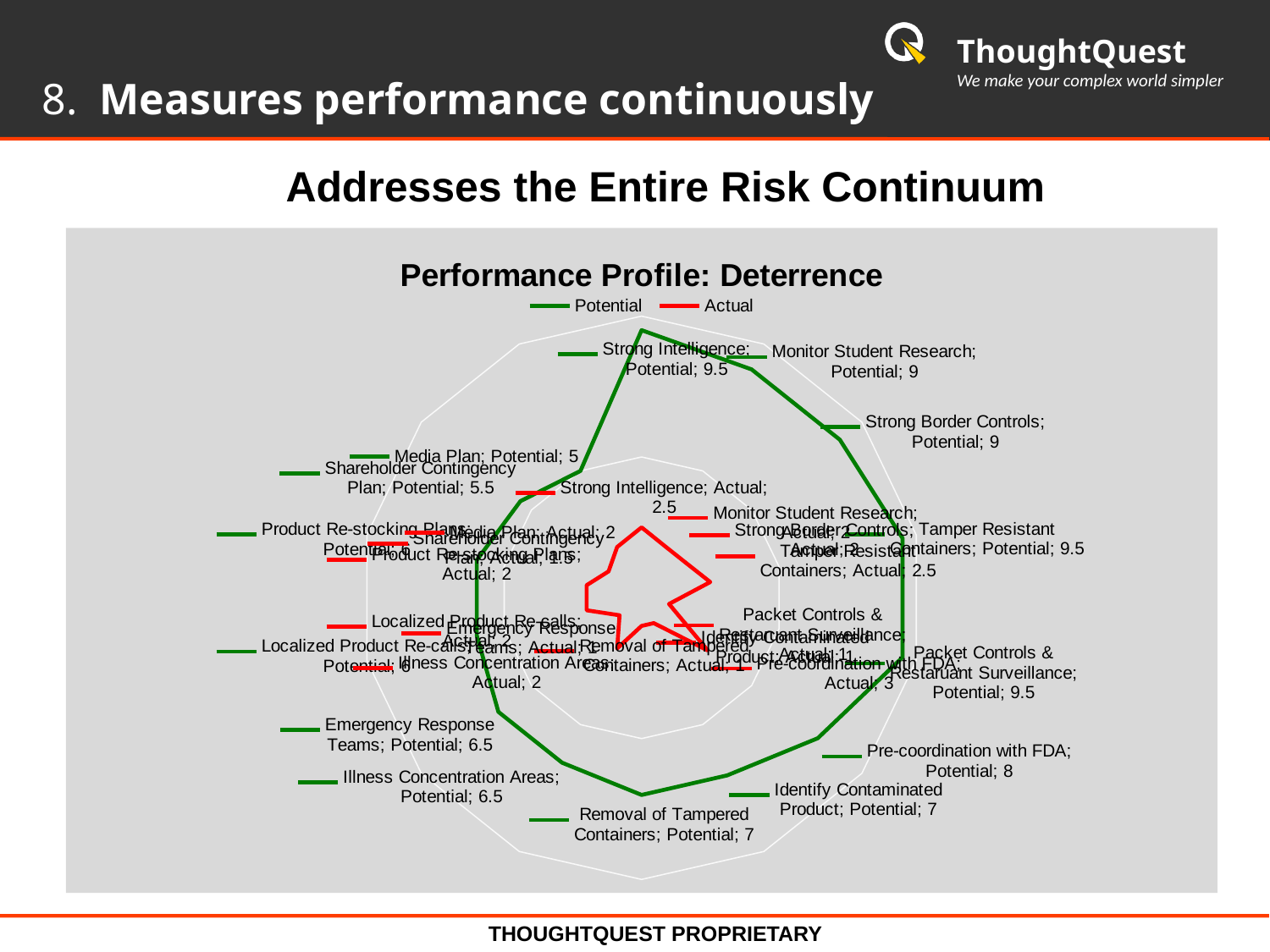
Which has the larger Potential value, Strong Border Controls or Media Plan? Strong Border Controls How many series does the legend of the Performance Profile: Deterrence chart list? 2 What is the Potential value for Strong Intelligence? 9.5 What kind of chart is shown on the slide? Radar chart What is the title of the chart? Performance Profile: Deterrence Which category has the lowest Potential value? Media Plan What is the Potential value for Emergency Response Teams? 6.5 What is the Potential value for Media Plan? 5 What is the Actual value for Pre-coordination with FDA? 3 What is the Actual value for Strong Intelligence? 2.5 What is the difference between the Potential and Actual values for Strong Intelligence? 7 Which category has the highest Actual value? Pre-coordination with FDA